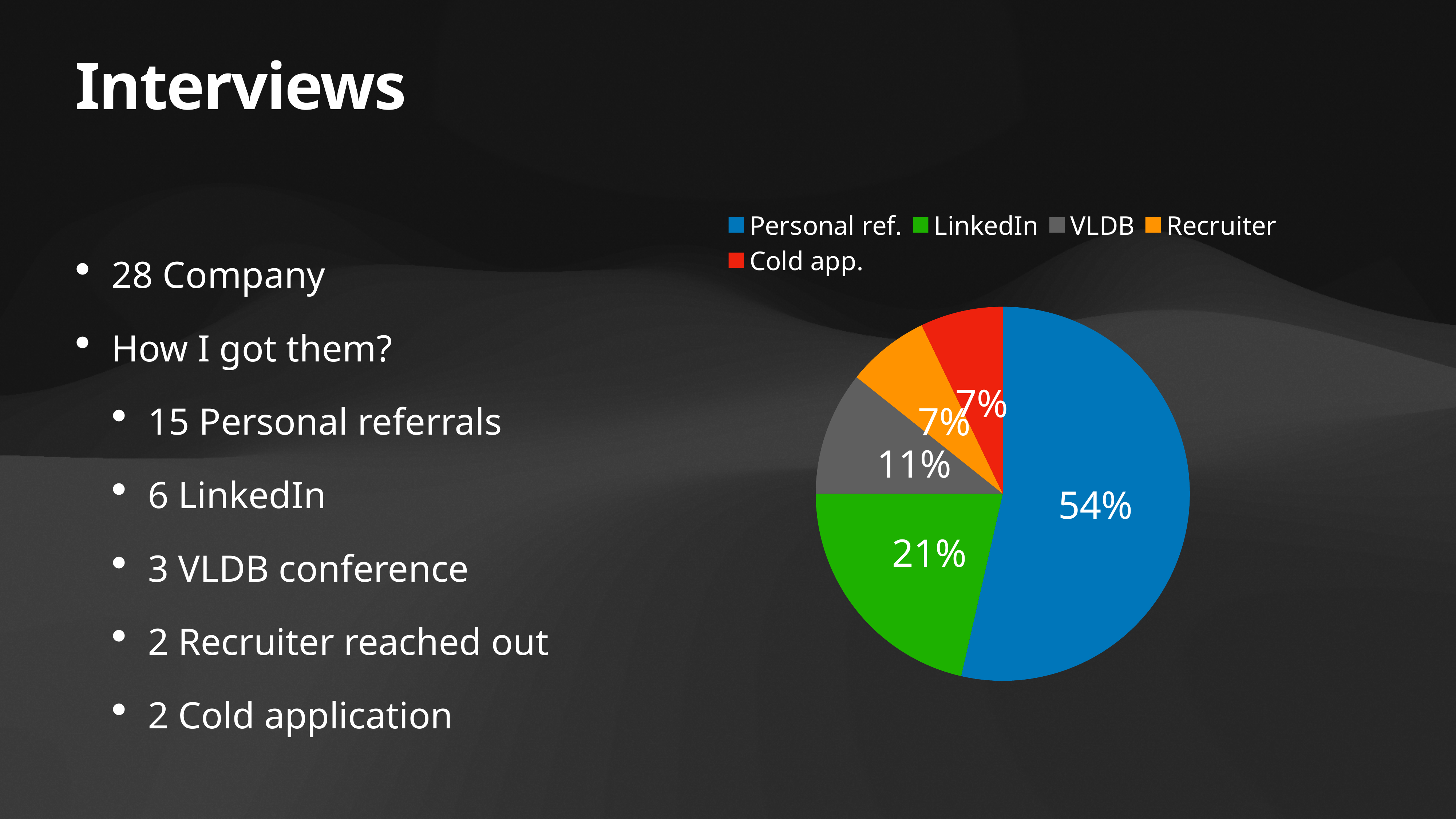
How many categories does the legend list? 5 What share of the pie does Personal ref. have? 54% What is the difference in percentage points between the LinkedIn slice and the VLDB slice? 10 Is the share for Personal ref. greater or less than 50%? greater What is the difference in percentage points between the Personal ref. slice and the LinkedIn slice? 33 Which slice is larger, LinkedIn or VLDB? LinkedIn Which category has the largest slice of the pie? Personal ref. Which legend entry is shown in red? Cold app. What share of the pie does LinkedIn have? 21% What share of the pie does VLDB have? 11% What kind of chart is shown on the slide? Pie chart What colour is the LinkedIn slice? Green